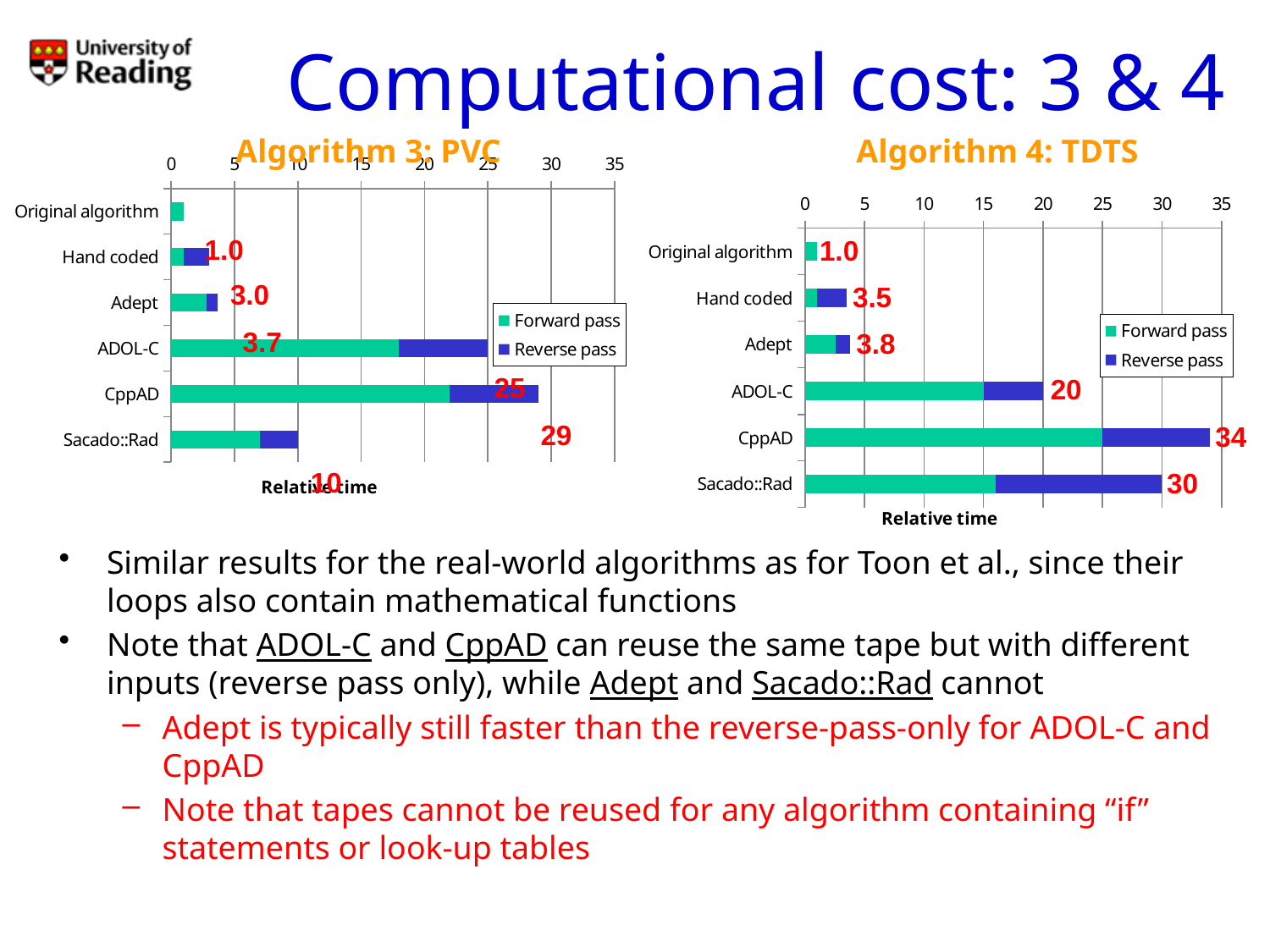
In the Algorithm 4: TDTS chart, which category has the highest total relative time? CppAD In the Algorithm 4: TDTS chart, what is the difference between the labelled values for CppAD and Sacado::Rad? 4 In the Algorithm 4: TDTS chart, what is the total relative time labelled for CppAD? 34 What kind of chart is the Algorithm 3: PVC chart? Stacked bar chart In the Algorithm 4: TDTS chart, what is the relative time labelled for ADOL-C? 20 In the Algorithm 3: PVC chart, is the total bar length for Sacado::Rad greater or less than 15? less In the Algorithm 4: TDTS chart, which has the larger relative time, ADOL-C or Sacado::Rad? Sacado::Rad How many series does the legend of the Algorithm 3: PVC chart list? 2 How many categories are shown on the y axis of the Algorithm 4: TDTS chart? 6 In the Algorithm 3: PVC chart, which category has the longest total bar? CppAD In the Algorithm 4: TDTS chart, which category has the lowest relative time? Original algorithm In the Algorithm 4: TDTS chart, what is the relative time labelled for Hand coded? 3.5